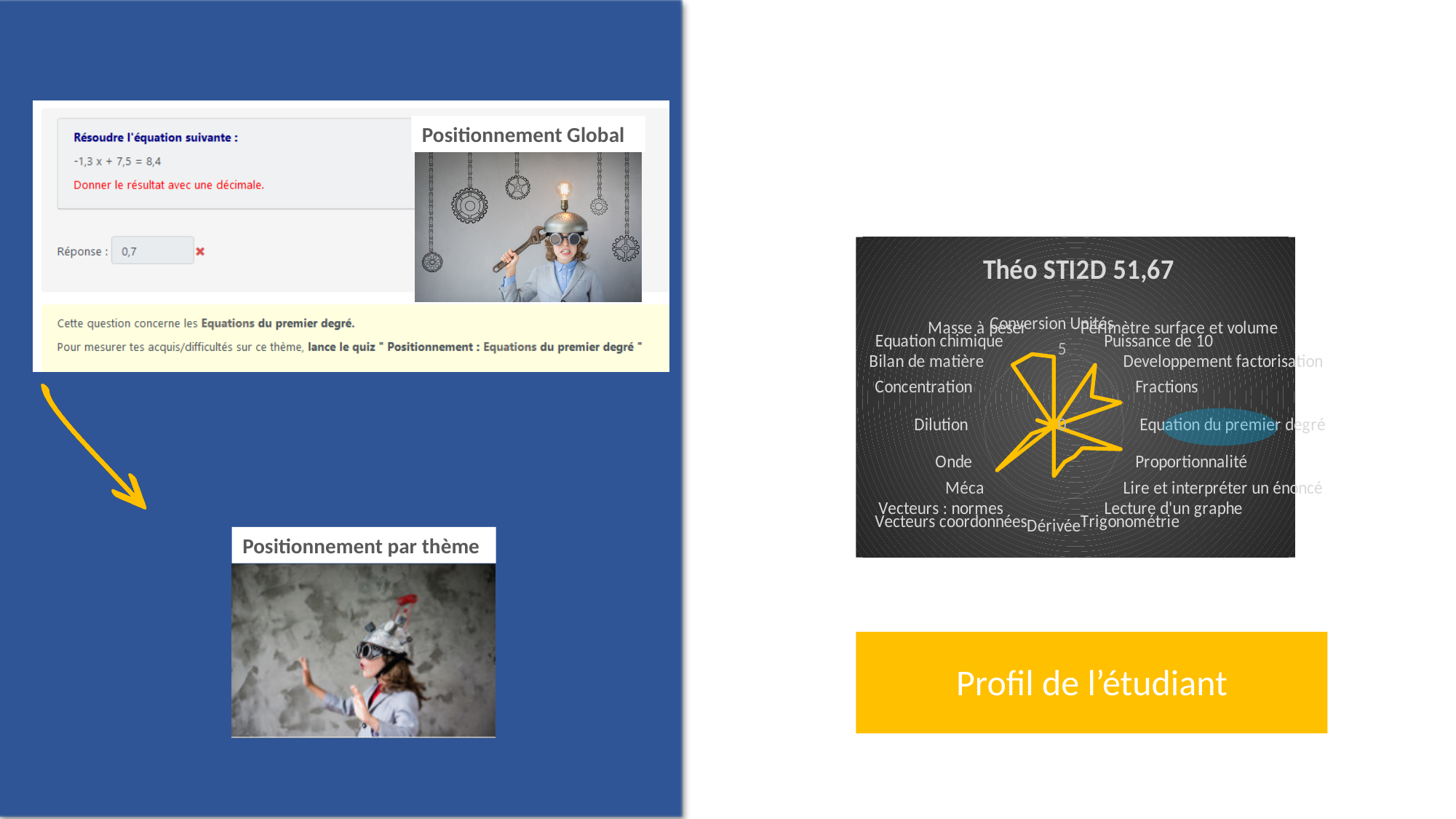
On the radar chart, is the value for Dérivée greater or less than 5? less Which category on the radar chart is highlighted with a blue ellipse? Equation du premier degré What is the title of the radar chart? Théo STI2D 51,67 On the radar chart, is the value for Dilution greater or less than 5? less What kind of chart is shown on the right side of the slide? radar chart